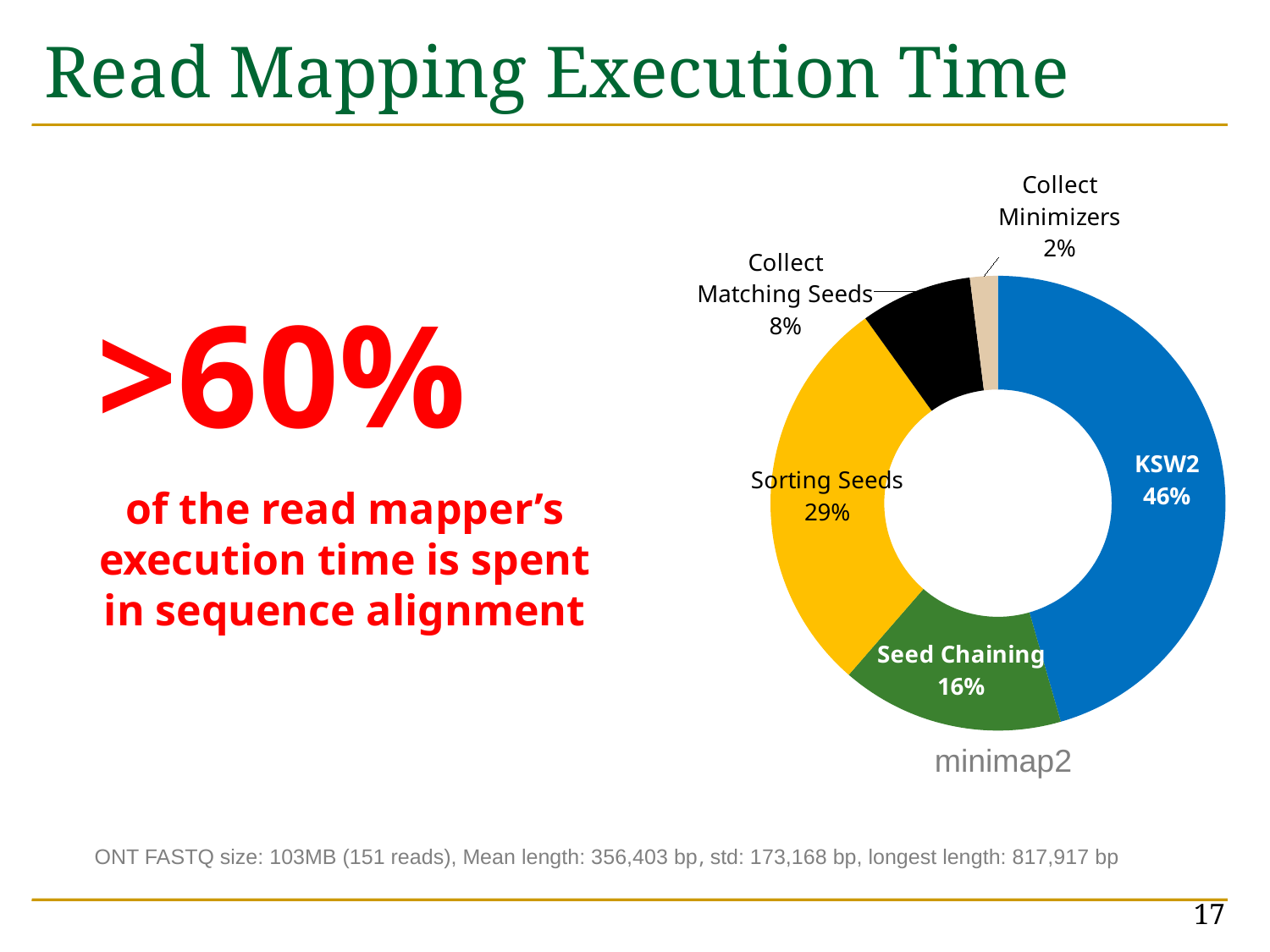
What kind of chart is shown on the slide? Doughnut chart What share of minimap2's execution time is spent in KSW2? 46% Which has a larger share: Seed Chaining or Collect Matching Seeds? Seed Chaining What percentage is shown for Collect Matching Seeds? 8% How many stages are shown in the chart? 5 How many percentage points larger is KSW2's share than Sorting Seeds' share? 17 What percentage of execution time is attributed to Sorting Seeds? 29% Which stage accounts for the largest share of execution time? KSW2 What is the combined share of Seed Chaining and Sorting Seeds? 45% Which read mapper is the chart about, according to the label below it? minimap2 What is the value shown for Seed Chaining? 16% Which stage accounts for the smallest share of execution time? Collect Minimizers